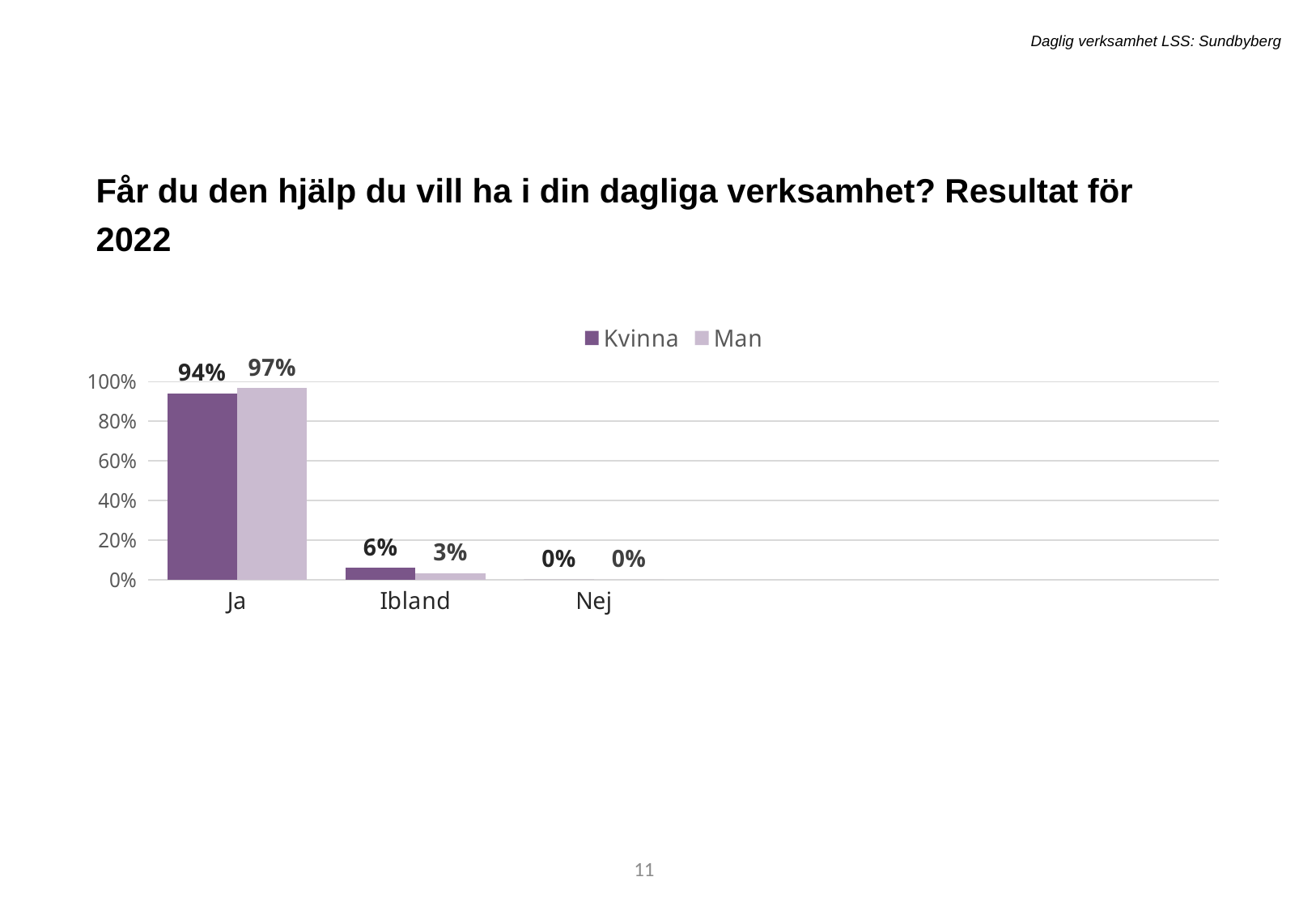
Which category has the highest value for the Man series? Ja How many categories are shown on the x axis? 3 What is the value for Man in the Ja category? 97% What kind of chart is shown on the slide? Bar chart What is the value for Kvinna in the Ibland category? 6% What is the value for Kvinna in the Ja category? 94% Which is larger in the Ibland category, Kvinna or Man? Kvinna What is the value for Man in the Nej category? 0% How many series does the legend list? 2 What is the difference between the Man and Kvinna values in the Ja category? 3% Which category has the lowest value for the Kvinna series? Nej Which series is shown in the darker purple colour? Kvinna